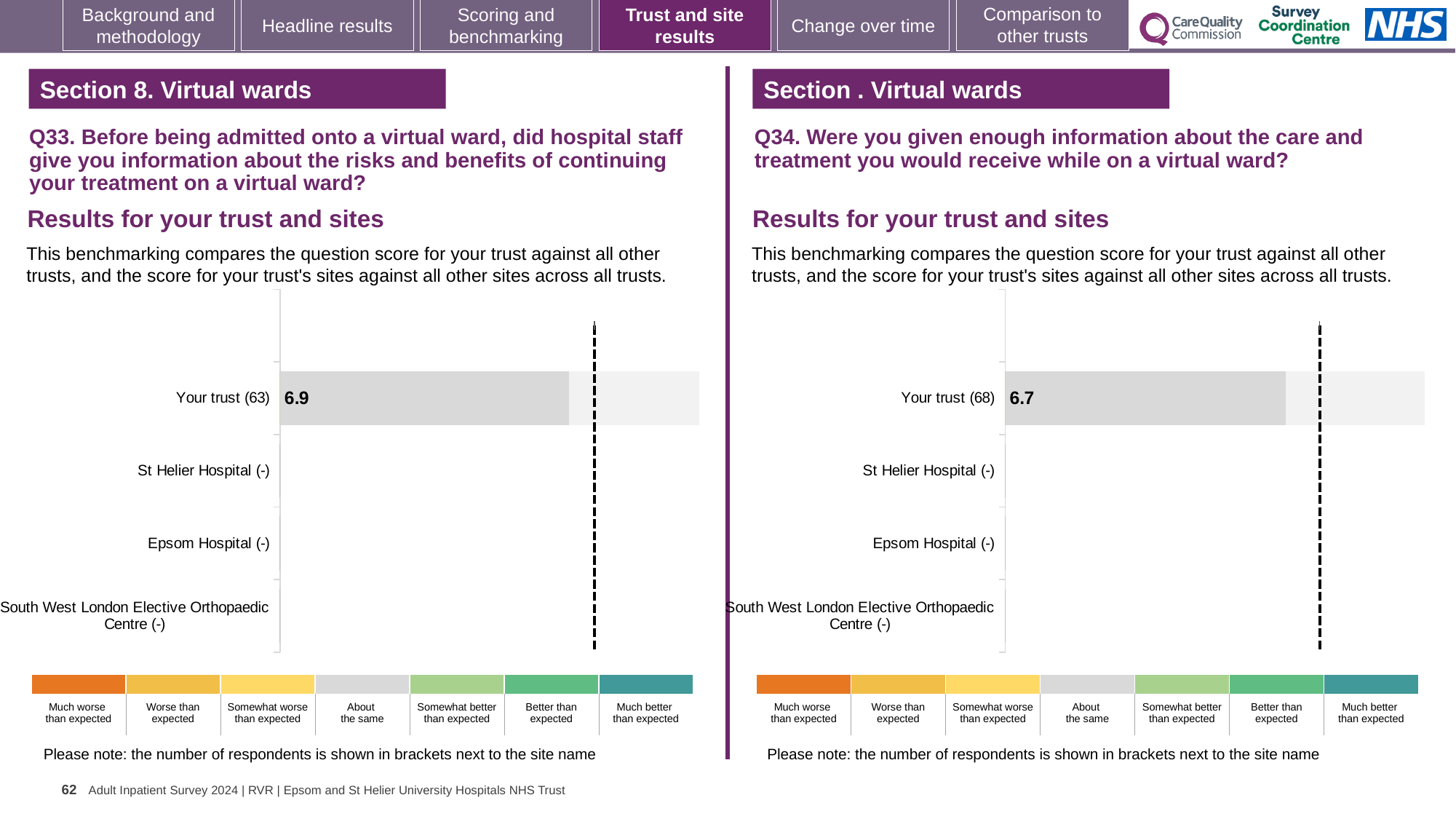
How many benchmark bands are shown in the colour key below the Q33 chart (left)? 7 On the Q34 chart (right), what is the score for Your trust? 6.7 On the Q34 chart (right), which category is listed last on the vertical axis? South West London Elective Orthopaedic Centre On the Q33 chart (left), what is the score for Your trust? 6.9 On the Q34 chart (right), how many respondents are shown in brackets next to Your trust? 68 What is the difference between the Your trust score on the Q33 chart and the Your trust score on the Q34 chart? 0.2 What kind of chart is used on the Q34 chart (right)? Bar chart Which chart shows a higher score for Your trust, the Q33 chart on the left or the Q34 chart on the right? Q33 chart (left) On the Q33 chart (left), which category has the highest score shown? Your trust How many categories are listed on the vertical axis of the Q33 chart (left)? 4 On the Q33 chart (left), how many respondents are shown in brackets next to Your trust? 63